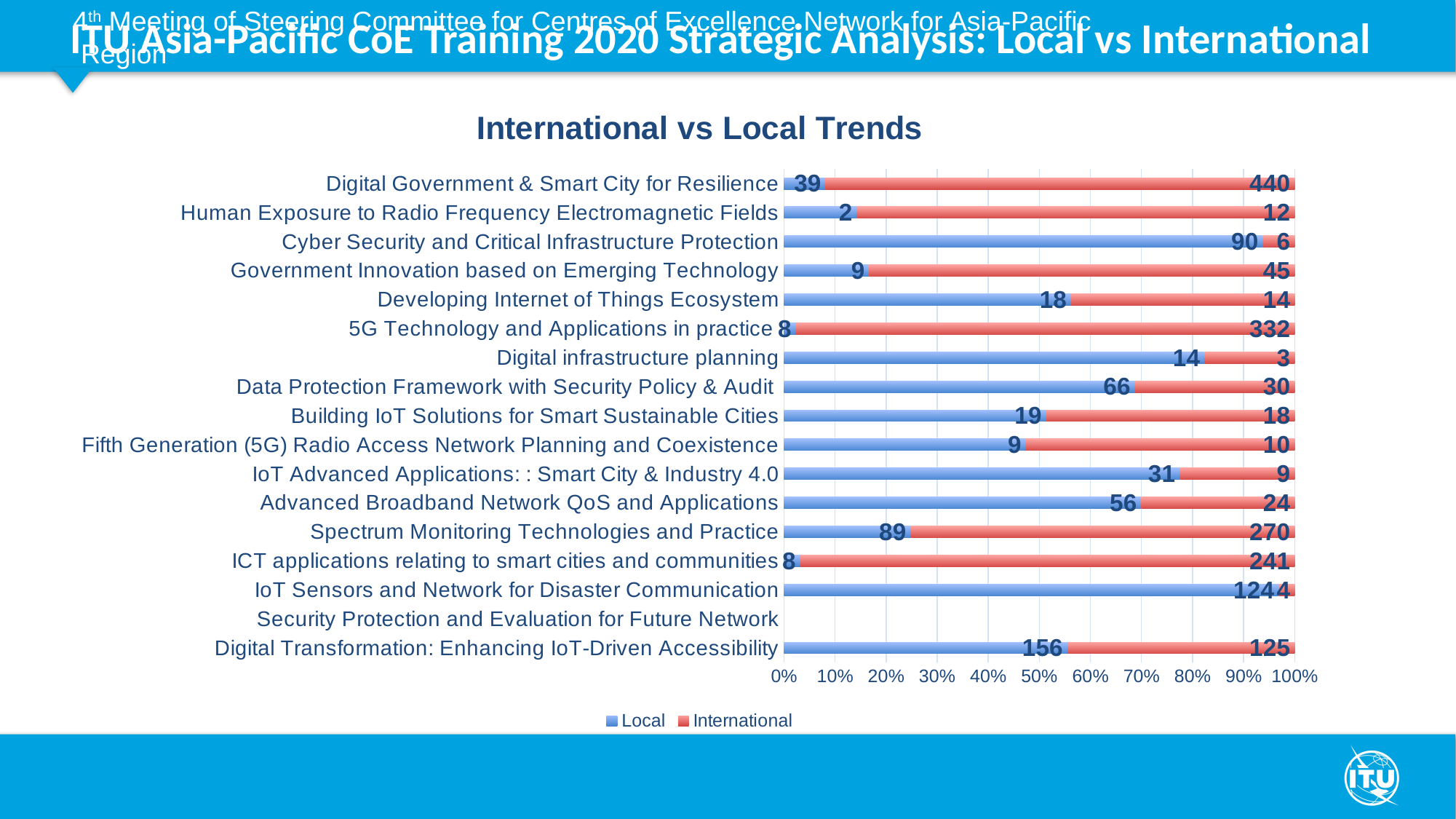
What is the International value for Digital Government & Smart City for Resilience? 440 What is the title of the chart? International vs Local Trends What is the combined Local and International total for Digital Transformation: Enhancing IoT-Driven Accessibility? 281 What is the Local value for Digital Transformation: Enhancing IoT-Driven Accessibility? 156 How many categories are listed on the vertical axis of the chart? 17 What is the International value for Spectrum Monitoring Technologies and Practice? 270 Which is larger for Data Protection Framework with Security Policy & Audit, the Local value or the International value? Local What kind of chart is shown on the slide? Stacked bar chart Which category has the highest International value? Digital Government & Smart City for Resilience How many series does the legend list? 2 What is the difference between the International and Local values for 5G Technology and Applications in practice? 324 What is the Local value for Cyber Security and Critical Infrastructure Protection? 90